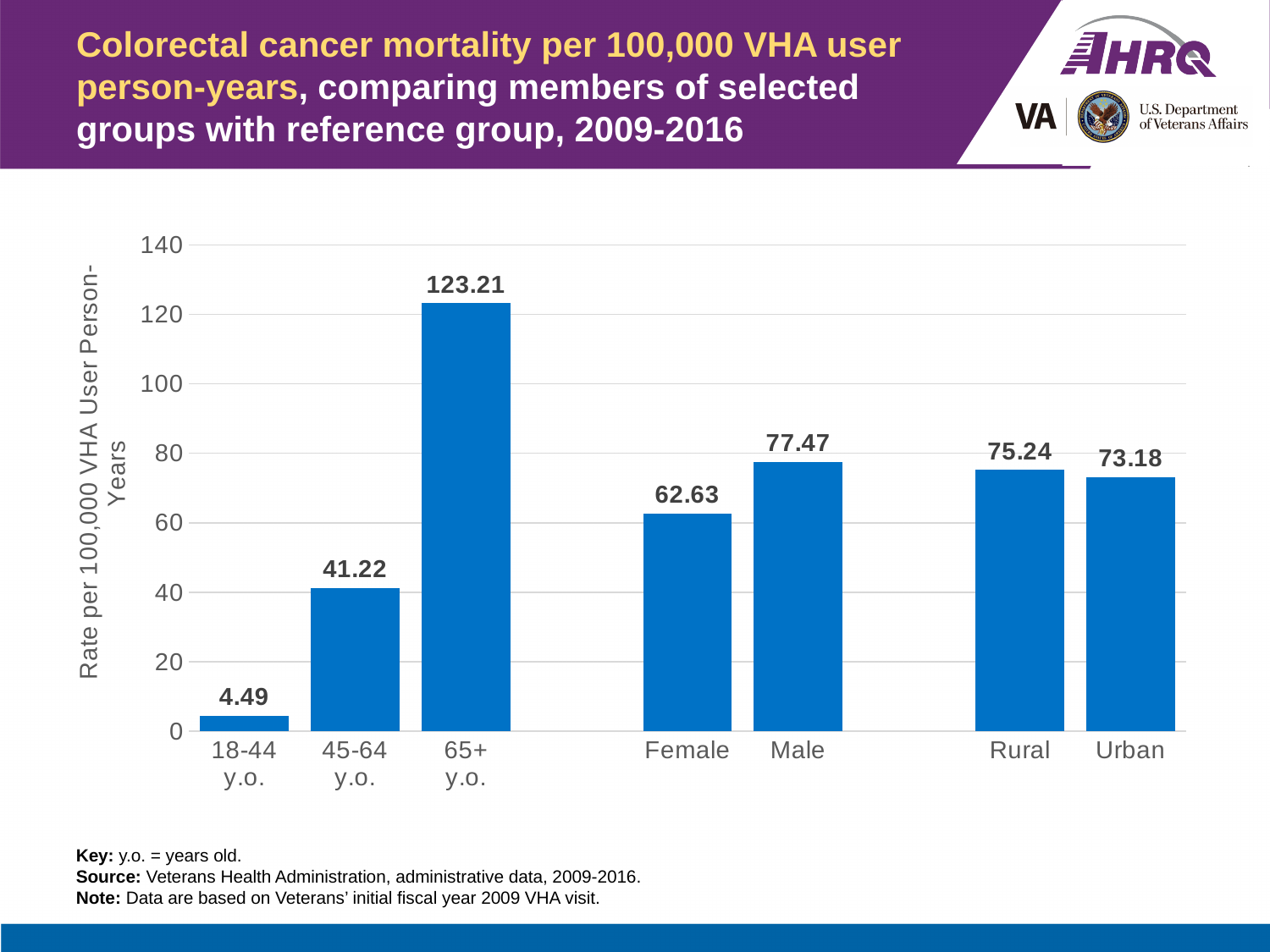
What is the label of the vertical axis? Rate per 100,000 VHA User Person-Years What is the colorectal cancer mortality rate for the 65+ y.o. group? 123.21 How many groups are shown on the chart? 7 What is the difference between the mortality rates for Male and Female VHA users? 14.84 Which group has the highest colorectal cancer mortality rate? 65+ y.o. What is the difference between the mortality rates for the 65+ y.o. and 45-64 y.o. groups? 81.99 Is the value for the 45-64 y.o. group greater or less than 40? greater What kind of chart is shown on the slide? Bar chart Which has a higher colorectal cancer mortality rate, Rural or Urban? Rural What is the colorectal cancer mortality rate for Rural VHA users? 75.24 What is the colorectal cancer mortality rate for Female VHA users? 62.63 Which group has the lowest colorectal cancer mortality rate? 18-44 y.o.